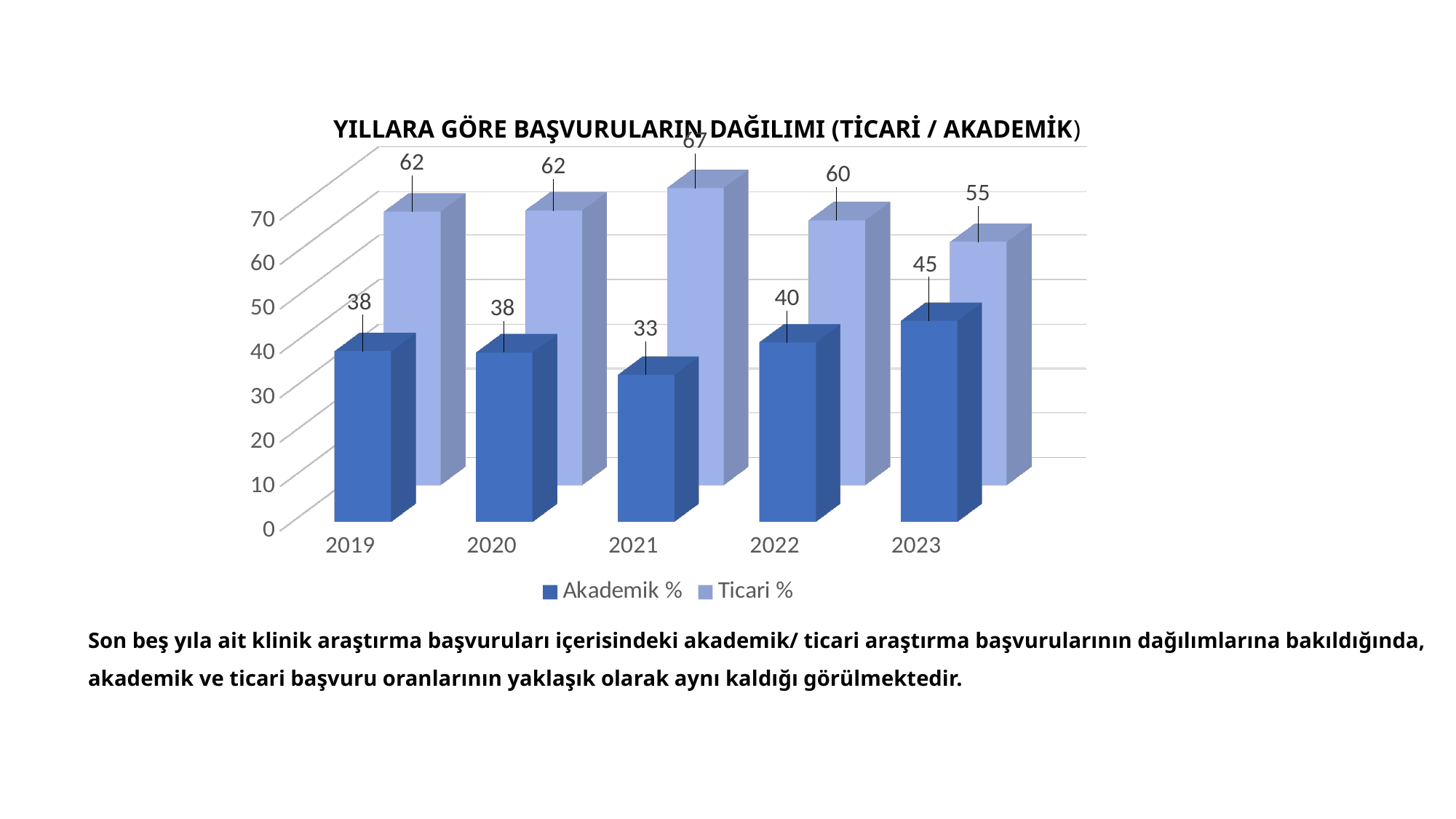
What is the Ticari % value for 2019? 62 What is the Ticari % value for 2023? 55 What is the title of the chart? YILLARA GÖRE BAŞVURULARIN DAĞILIMI (TİCARİ / AKADEMİK) How many series does the legend list? 2 Which year has the highest Ticari % value? 2021 Which year has the lowest Akademik % value? 2021 How many years are shown on the x axis? 5 Does the Ticari % value rise or fall from 2021 to 2023? Fall What is the Akademik % value for 2021? 33 What is the difference between the Ticari % and Akademik % values in 2022? 20 Which is larger in 2023, the Akademik % value or the Ticari % value? Ticari % What kind of chart is shown on the slide? Bar chart